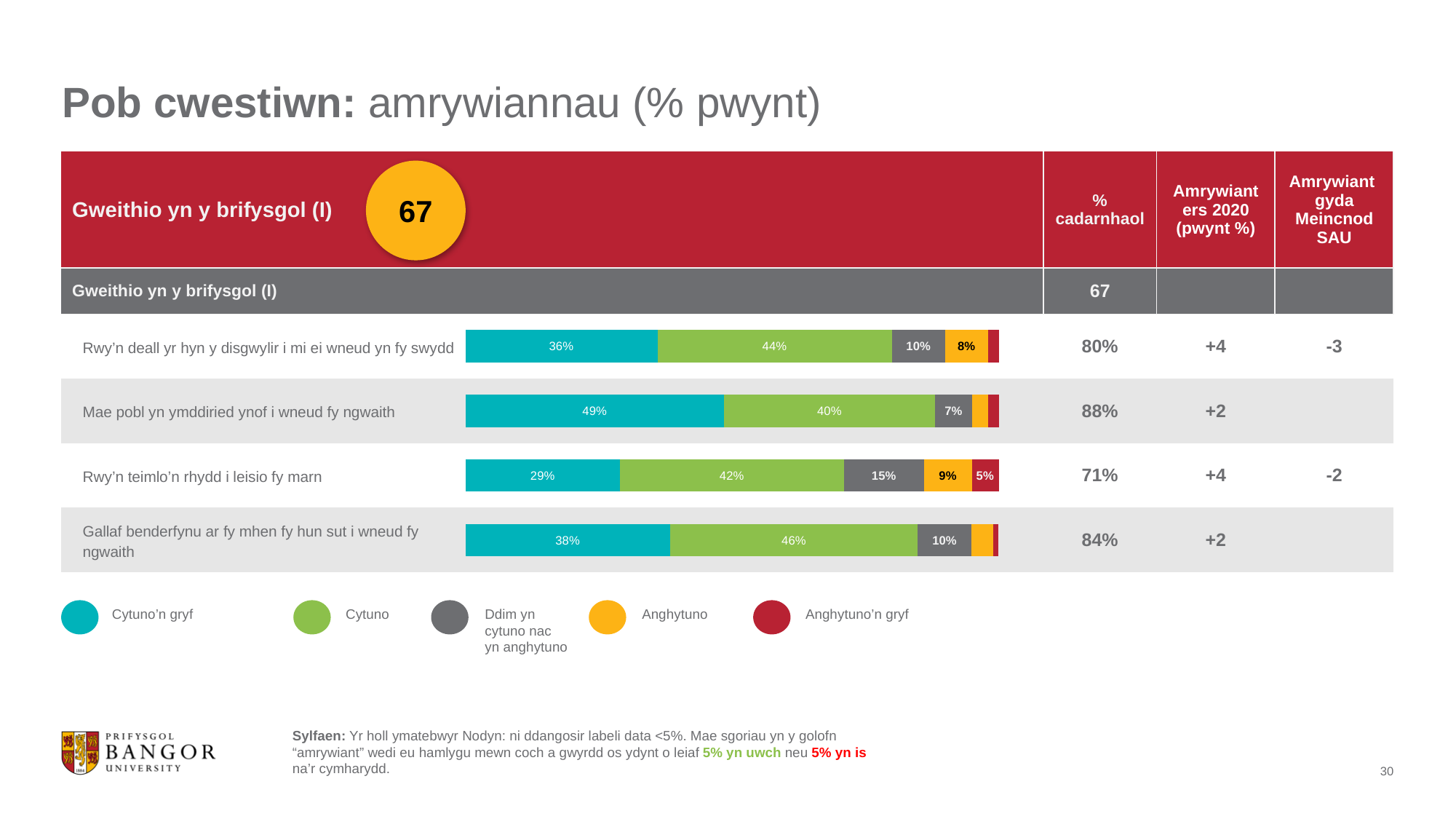
Which statement has the lowest Cytuno'n gryf (strongly agree) value? Rwy'n teimlo'n rhydd i leisio fy marn What is the difference between the Cytuno (agree) values for "Gallaf benderfynu ar fy mhen fy hun sut i wneud fy ngwaith" and "Rwy'n deall yr hyn y disgwylir i mi ei wneud yn fy swydd"? 2 percentage points What is the Ddim yn cytuno nac yn anghytuno (neither) value for "Rwy'n teimlo'n rhydd i leisio fy marn"? 15% Which has a larger Anghytuno (disagree) value: "Rwy'n deall yr hyn y disgwylir i mi ei wneud yn fy swydd" or "Rwy'n teimlo'n rhydd i leisio fy marn"? Rwy'n teimlo'n rhydd i leisio fy marn What kind of chart is shown on the slide? Stacked bar chart How many response categories does the legend list? 5 Which colour represents Anghytuno (disagree) in the legend? Orange/yellow Which statement has the highest Cytuno'n gryf (strongly agree) value? Mae pobl yn ymddiried ynof i wneud fy ngwaith How many statements are plotted in the chart? 4 What is the Cytuno (agree) value for "Rwy'n teimlo'n rhydd i leisio fy marn"? 42% What is the total of the labelled segments in the bar for "Rwy'n teimlo'n rhydd i leisio fy marn"? 100% What percentage of respondents strongly agree (Cytuno'n gryf) with "Mae pobl yn ymddiried ynof i wneud fy ngwaith"? 49%